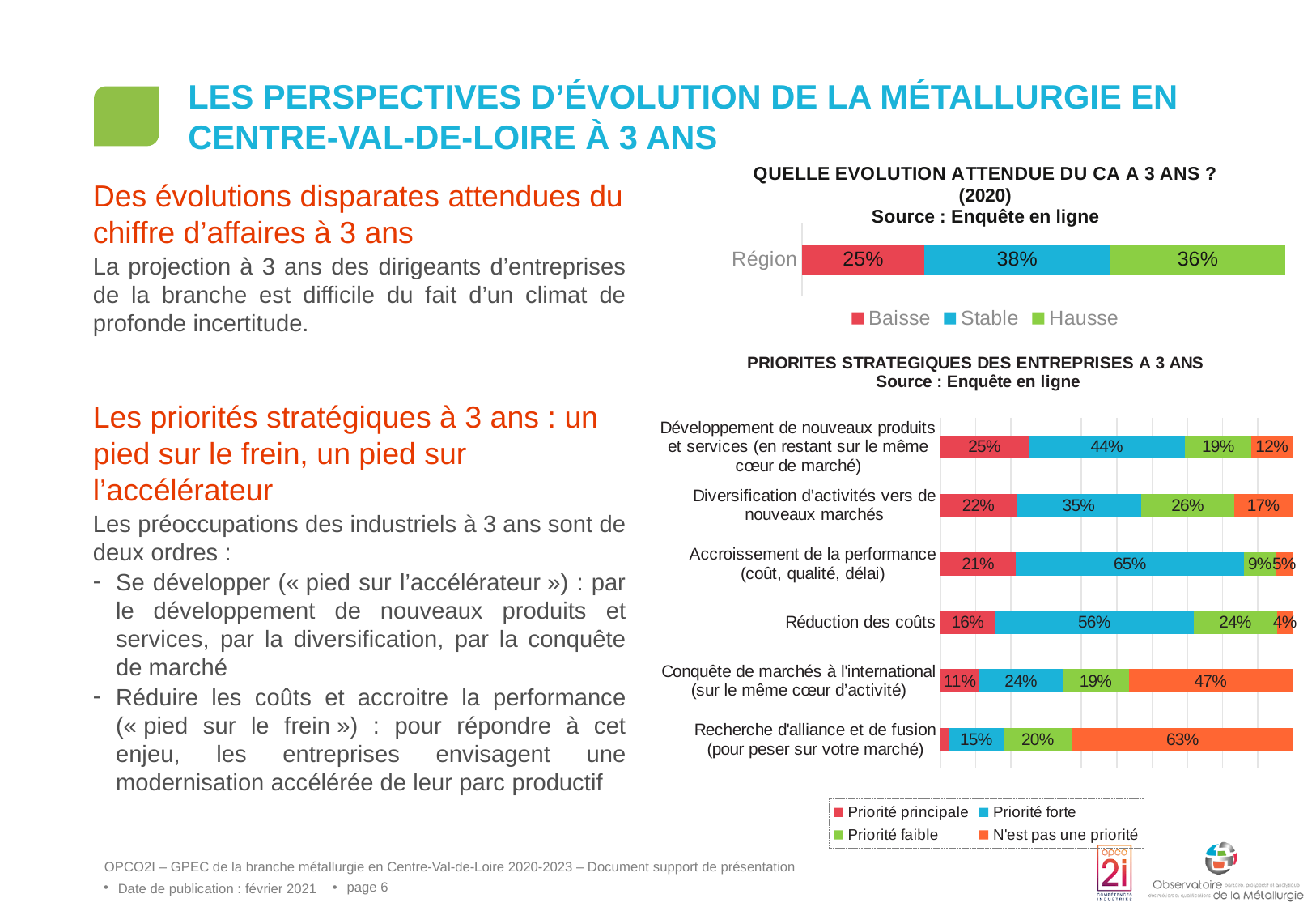
In the chart 'PRIORITES STRATEGIQUES DES ENTREPRISES A 3 ANS', what is the difference between the 'N'est pas une priorité' values for 'Conquête de marchés à l'international' and 'Développement de nouveaux produits et services'? 35% What type of chart is 'PRIORITES STRATEGIQUES DES ENTREPRISES A 3 ANS'? Stacked bar chart In the chart 'PRIORITES STRATEGIQUES DES ENTREPRISES A 3 ANS', what is the 'Priorité forte' value for 'Accroissement de la performance (coût, qualité, délai)'? 65% In the chart 'PRIORITES STRATEGIQUES DES ENTREPRISES A 3 ANS', what is the 'N'est pas une priorité' value for 'Recherche d'alliance et de fusion (pour peser sur votre marché)'? 63% In the chart 'PRIORITES STRATEGIQUES DES ENTREPRISES A 3 ANS', which is larger: the 'Priorité forte' value for 'Réduction des coûts' or for 'Diversification d'activités vers de nouveaux marchés'? Réduction des coûts In the chart 'QUELLE EVOLUTION ATTENDUE DU CA A 3 ANS ?', how many series does the legend list? 3 In the chart 'QUELLE EVOLUTION ATTENDUE DU CA A 3 ANS ?', what is the value for 'Stable'? 38% In the chart 'PRIORITES STRATEGIQUES DES ENTREPRISES A 3 ANS', how many categories are shown? 6 In the chart 'QUELLE EVOLUTION ATTENDUE DU CA A 3 ANS ?', which segment is the smallest? Baisse In the chart 'PRIORITES STRATEGIQUES DES ENTREPRISES A 3 ANS', which category has the highest 'Priorité principale' value? Développement de nouveaux produits et services (en restant sur le même cœur de marché) In the chart 'QUELLE EVOLUTION ATTENDUE DU CA A 3 ANS ?', what is the difference between 'Stable' and 'Baisse'? 13% In the chart 'PRIORITES STRATEGIQUES DES ENTREPRISES A 3 ANS', how many series does the legend list? 4